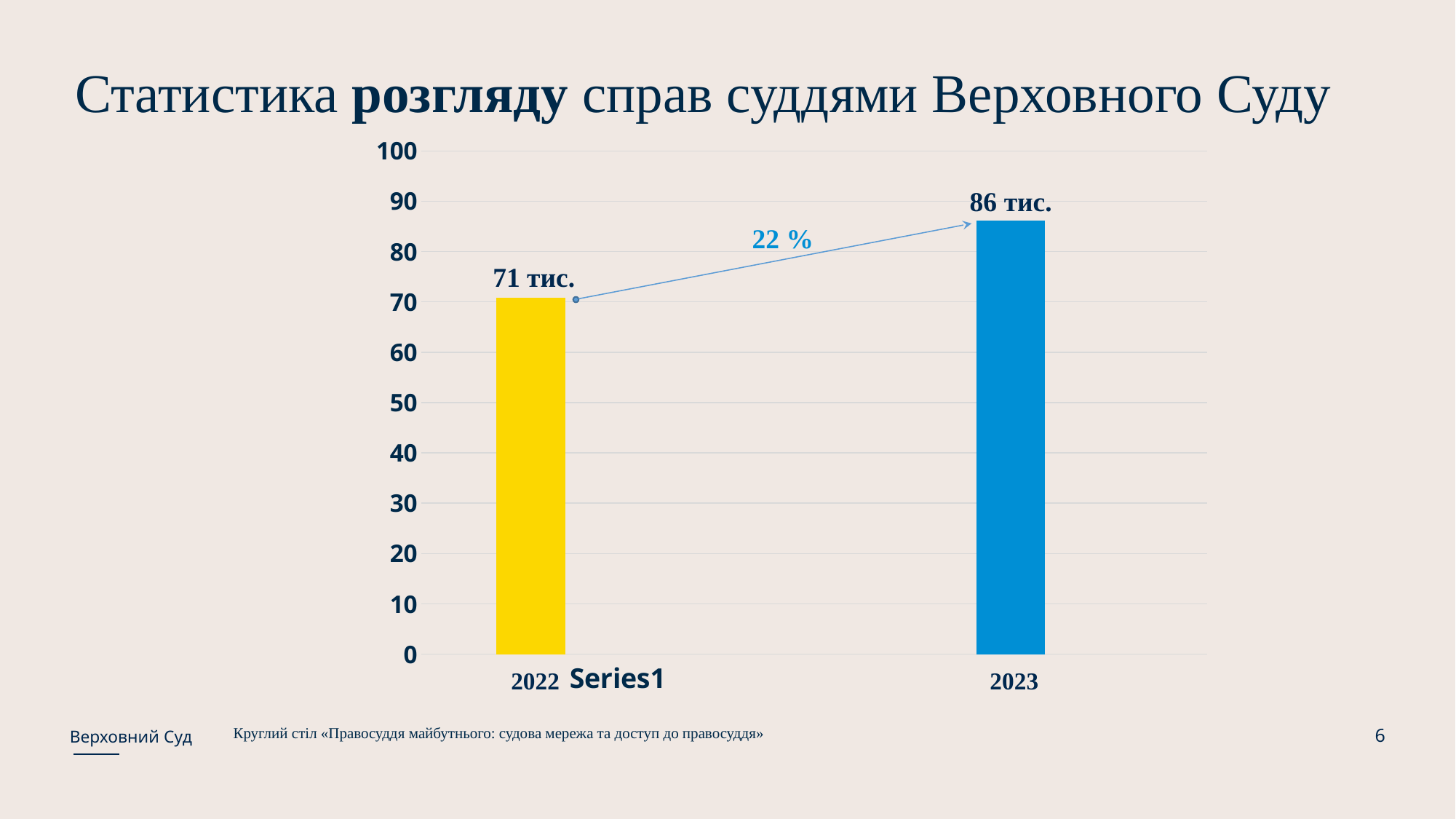
Is the value for 2022 greater or less than 80? less Is the value for 2023 larger than the value for 2022? Yes What is the value for 2023? 86 тис. By how much does the 2023 value exceed the 2022 value, in thousands? 15 тис. How many bars are shown in the chart? 2 Is the value for 2023 greater or less than 80? greater Which year has the higher value? 2023 What percentage change is annotated on the arrow between the two bars? 22 % What kind of chart is shown on the slide? Bar chart Do the values rise or fall from 2022 to 2023? Rise Which year has the lower value? 2022 What is the value for 2022? 71 тис.